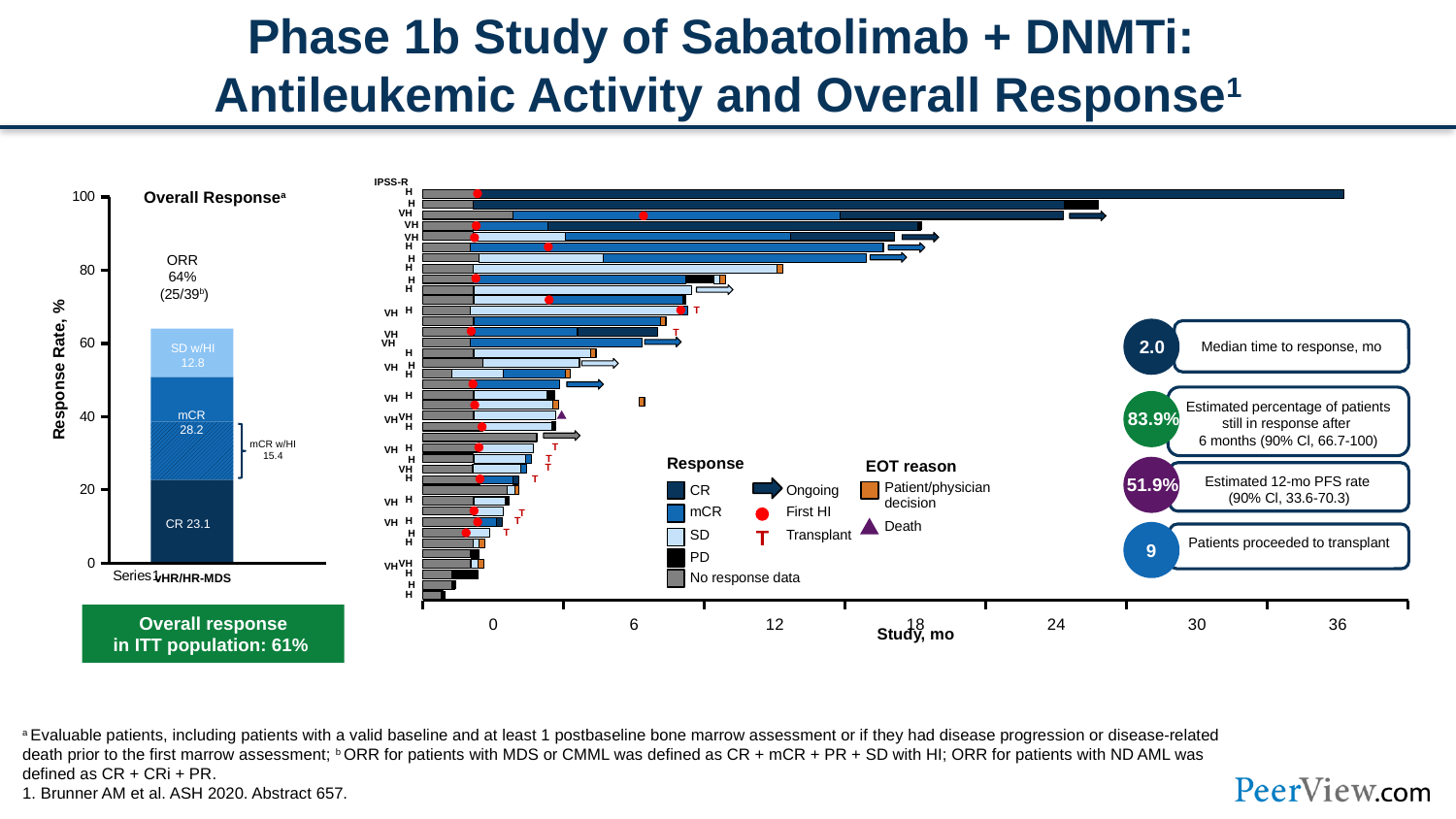
In the Overall Response bar chart, what ORR is printed above the bar? 64% (25/39) What type of chart is the Overall Response chart on the left? Stacked bar chart In the Overall Response bar chart, what value is given for mCR w/HI? 15.4 In the swimmer plot on the right, how many response categories does the Response legend list? 5 In the Overall Response bar chart, what is the difference between the mCR and CR values? 5.1 In the Overall Response bar chart, what is the value of the CR segment? 23.1 In the Overall Response bar chart, which segment has the largest value? mCR In the Overall Response bar chart, which is larger, CR or SD w/HI? CR In the Overall Response bar chart, what is the value of the SD w/HI segment? 12.8 In the swimmer plot on the right, is the longest bar greater or less than 30 months? greater In the Overall Response bar chart, what is the value of the mCR segment? 28.2 In the Overall Response bar chart, which segment has the smallest value? SD w/HI